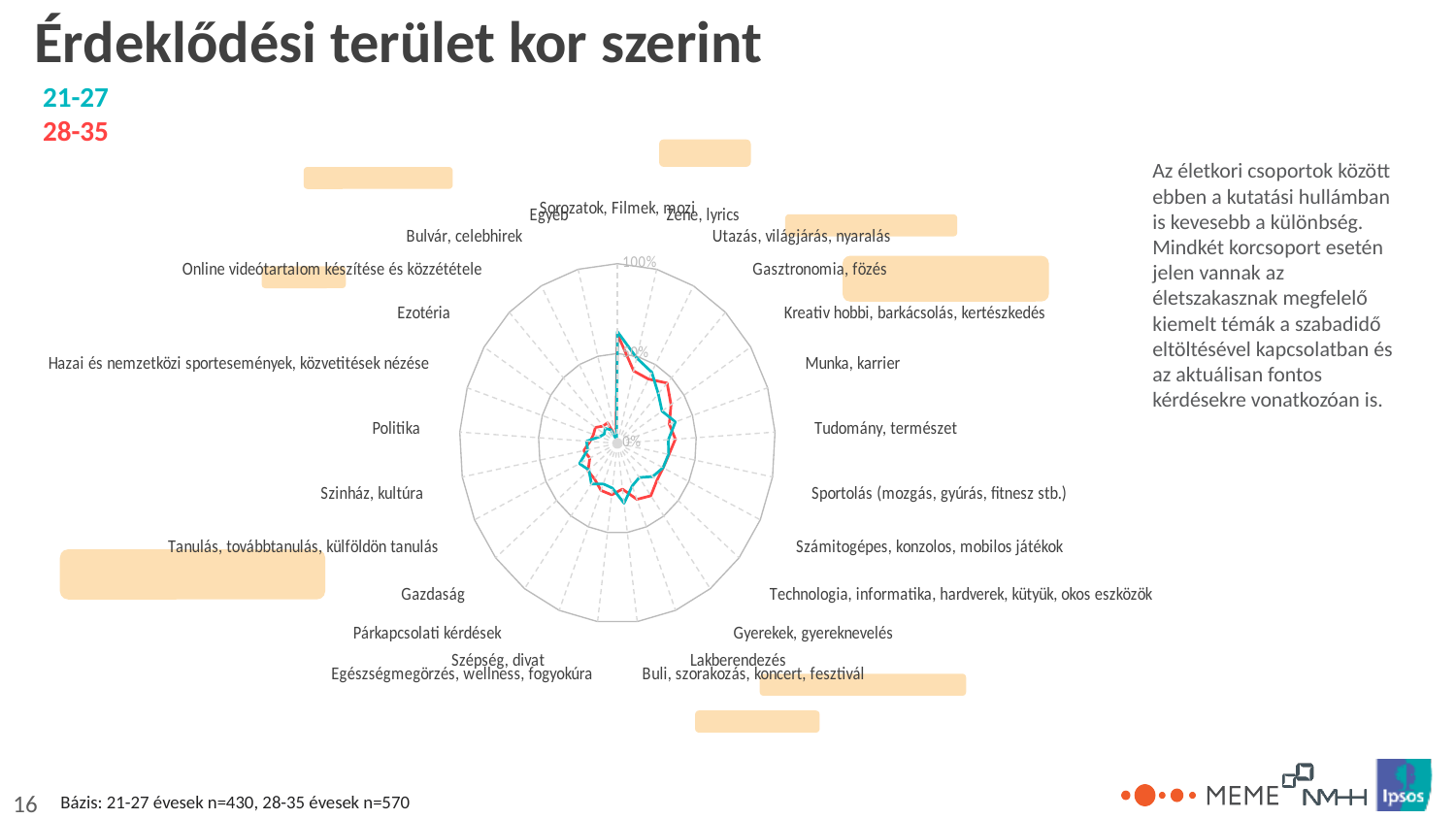
Is the value for Gazdaság for the 28-35 group greater or less than 50%? less How many interest categories are plotted around the radar chart? 25 What kind of chart is shown on the slide? Radar chart How many series does the legend list? 2 Which category has the highest value for the 28-35 group? Sorozatok, Filmek, mozi For the 28-35 group, which is larger: Sorozatok, Filmek, mozi or Politika? Sorozatok, Filmek, mozi Is the value for Ezotéria for the 28-35 group greater or less than 50%? less What is the maximum value shown on the chart's radial axis? 100% Which two age groups are compared in the chart? 21-27 and 28-35 Is the value for Politika for the 21-27 group greater or less than 50%? less For the 21-27 group, which is larger: Sorozatok, Filmek, mozi or Ezotéria? Sorozatok, Filmek, mozi